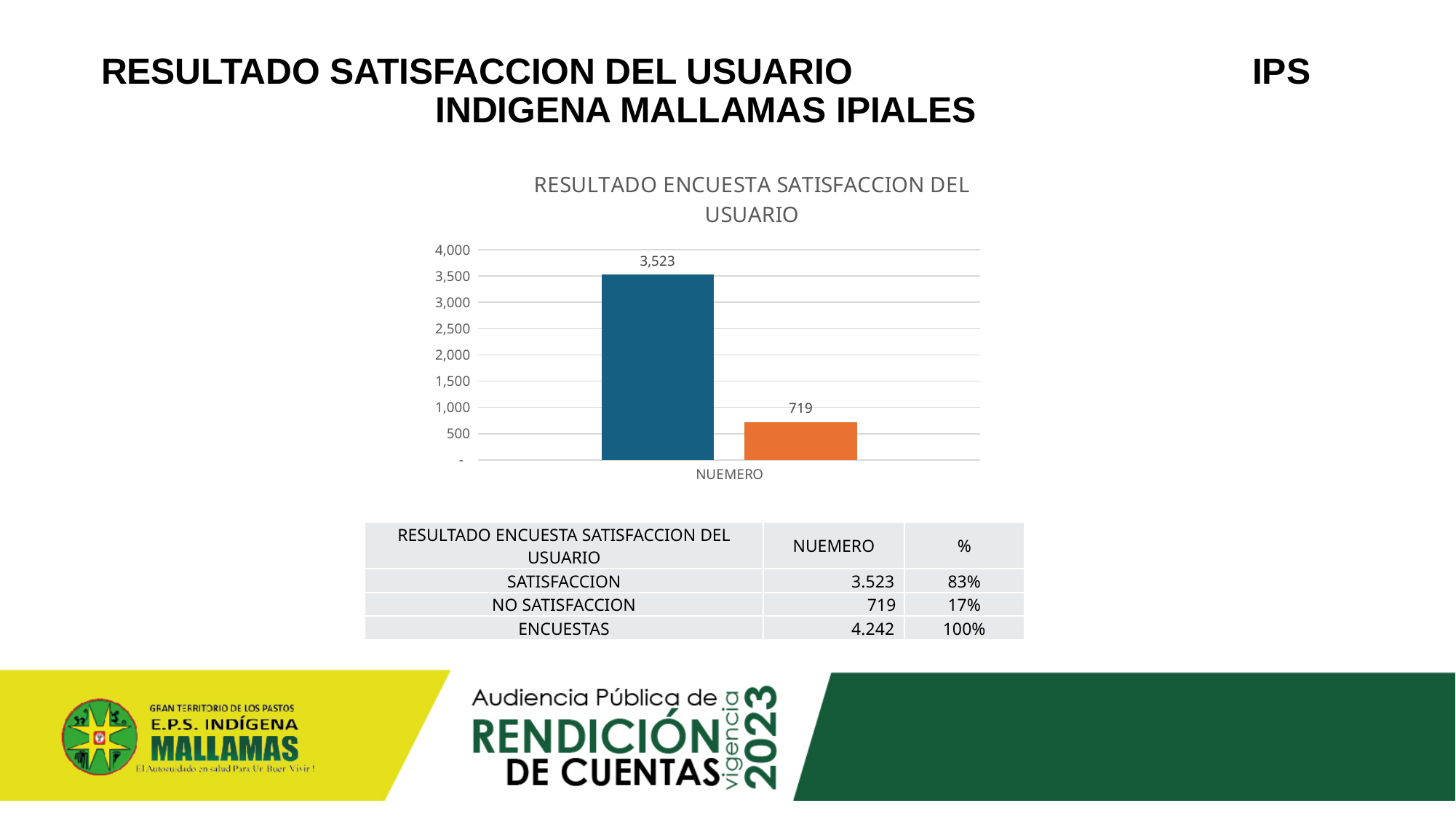
What is the category label shown on the horizontal axis of the chart? NUEMERO What is the difference between the values of the blue bar and the orange bar in the chart? 2,804 Which bar in the chart is the tallest, the blue one or the orange one? the blue one What value is labelled on the orange bar in the chart? 719 What is the title of the chart on the slide? RESULTADO ENCUESTA SATISFACCION DEL USUARIO What kind of chart is shown on the slide? bar chart What is the highest value shown on the vertical axis of the chart? 4,000 What value is labelled on the blue bar in the chart? 3,523 Which bar in the chart is the shortest, the blue one or the orange one? the orange one Is the value of the orange bar in the chart greater or less than 1,000? less Is the value of the blue bar in the chart greater or less than 3,000? greater How many bars are plotted in the chart? 2